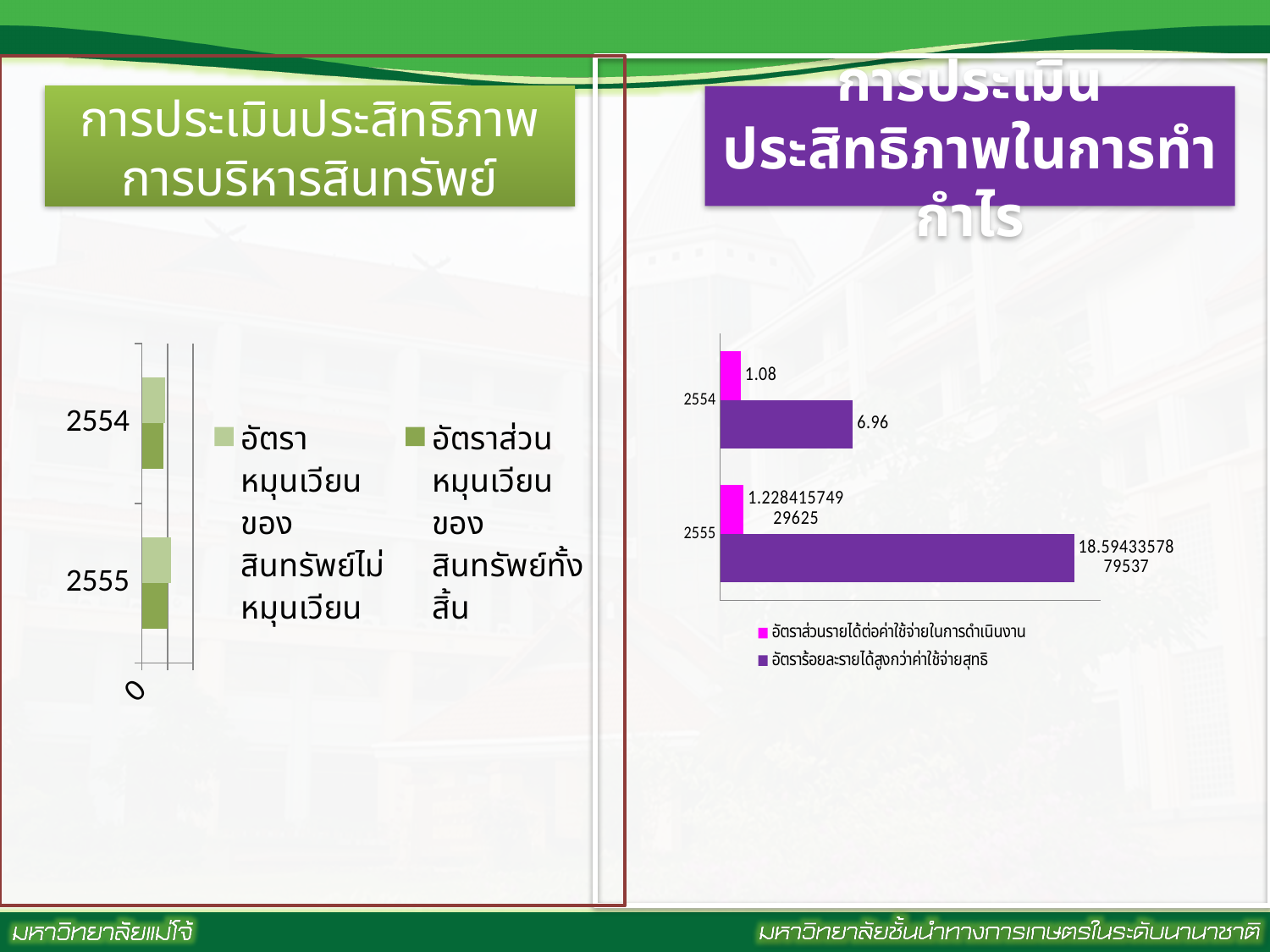
In the chart titled การประเมินประสิทธิภาพในการทำกำไร (right), what is the value of อัตราร้อยละรายได้สูงกว่าค่าใช้จ่ายสุทธิ for 2554? 6.96 How many series does the legend of the right-hand chart list? 2 In the right-hand chart, what is the difference between the two values shown for 2554? 5.88 In the right-hand chart, which bar has the lowest value? อัตราส่วนรายได้ต่อค่าใช้จ่ายในการดำเนินงาน for 2554 In the right-hand chart, which year has the larger value for อัตราร้อยละรายได้สูงกว่าค่าใช้จ่ายสุทธิ, 2554 or 2555? 2555 How many series does the legend of the left-hand chart list? 2 In the right-hand chart, what colour are the bars for อัตราส่วนรายได้ต่อค่าใช้จ่ายในการดำเนินงาน? Magenta In the chart titled การประเมินประสิทธิภาพในการทำกำไร (right), what is the value of อัตราส่วนรายได้ต่อค่าใช้จ่ายในการดำเนินงาน for 2554? 1.08 How many year categories are shown in the left-hand chart (การประเมินประสิทธิภาพการบริหารสินทรัพย์)? 2 In the right-hand chart, which bar has the highest value? อัตราร้อยละรายได้สูงกว่าค่าใช้จ่ายสุทธิ for 2555 In the right-hand chart, which year has the larger value for อัตราส่วนรายได้ต่อค่าใช้จ่ายในการดำเนินงาน, 2554 or 2555? 2555 What type of chart is the right-hand chart (การประเมินประสิทธิภาพในการทำกำไร)? Bar chart